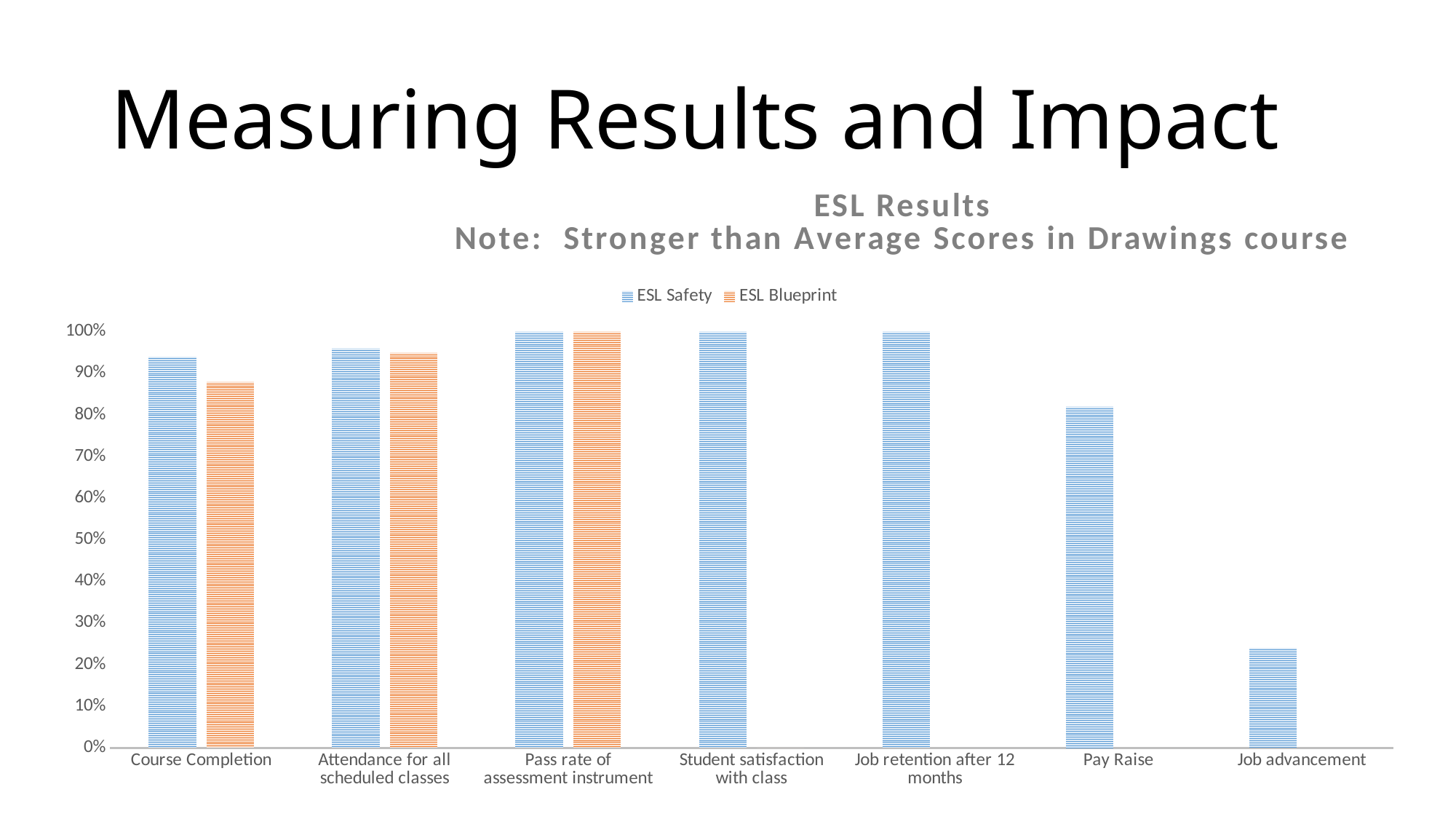
How many series does the legend list? 2 What are the two series named in the legend? ESL Safety and ESL Blueprint Is the ESL Safety value for Pay Raise greater or less than 90%? less What is the ESL Safety value for Student satisfaction with class? 100% What kind of chart is shown on the slide? bar chart Is the ESL Blueprint value for Course Completion greater or less than 80%? greater Is the ESL Safety value for Job advancement greater or less than 30%? less How many categories are shown along the x axis? 7 Which is larger for ESL Safety, Pay Raise or Job advancement? Pay Raise Which category has the lowest value for ESL Safety? Job advancement How many categories have an ESL Blueprint bar? 3 For Course Completion, which series has the larger value, ESL Safety or ESL Blueprint? ESL Safety